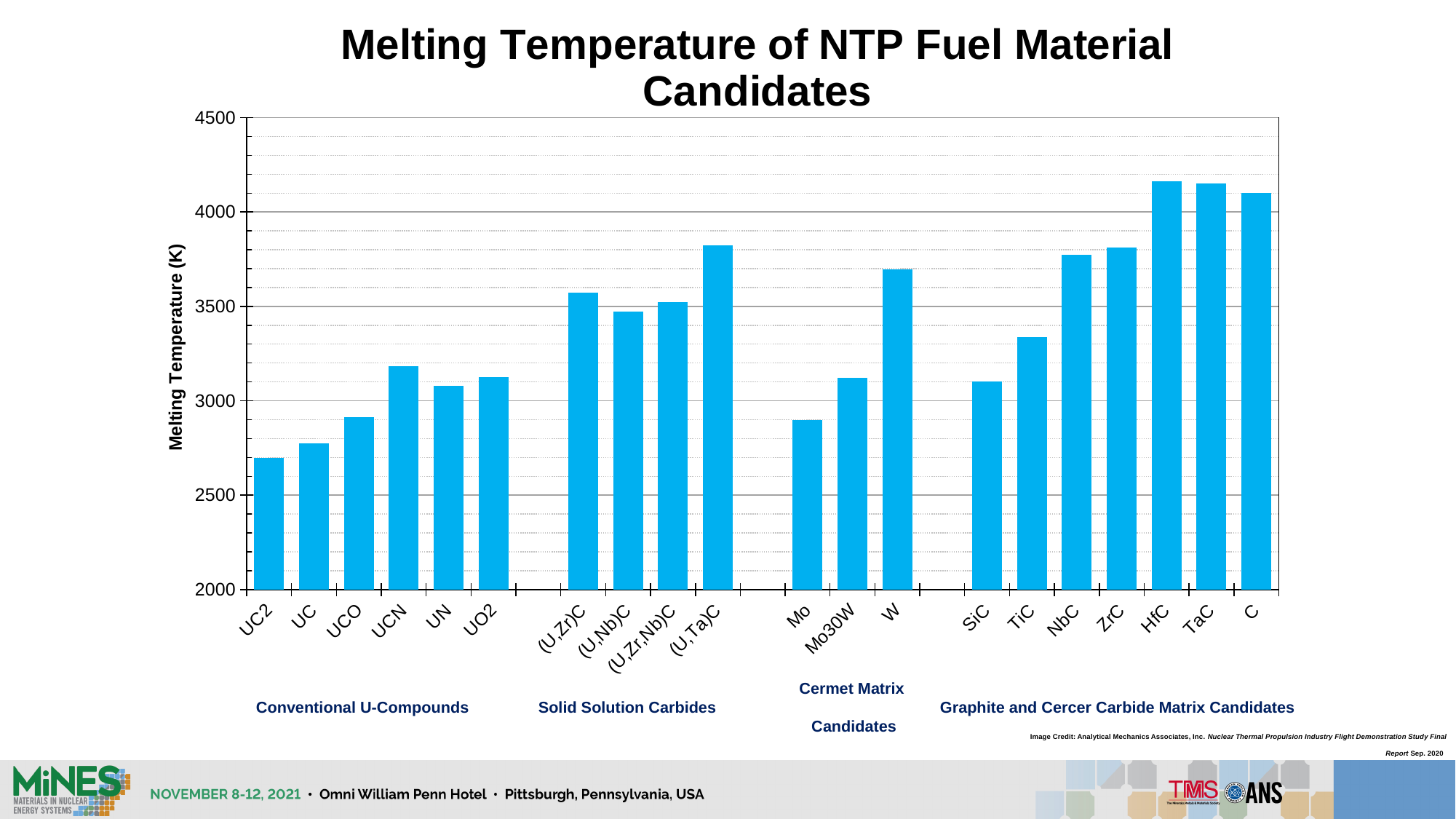
Which has a higher melting temperature, (U,Ta)C or (U,Zr)C? (U,Ta)C Is the melting temperature for (U,Ta)C greater or less than 3500? greater Which material has the lowest melting temperature in the chart? UC2 What is the title of the vertical axis? Melting Temperature (K) Is the melting temperature for HfC greater or less than 4000? greater Which has a higher melting temperature, C or SiC? C What kind of chart is shown on the slide? bar chart Which has a higher melting temperature, W or Mo? W Is the melting temperature for UC2 greater or less than 3000? less How many bars (material candidates) are plotted in the chart? 20